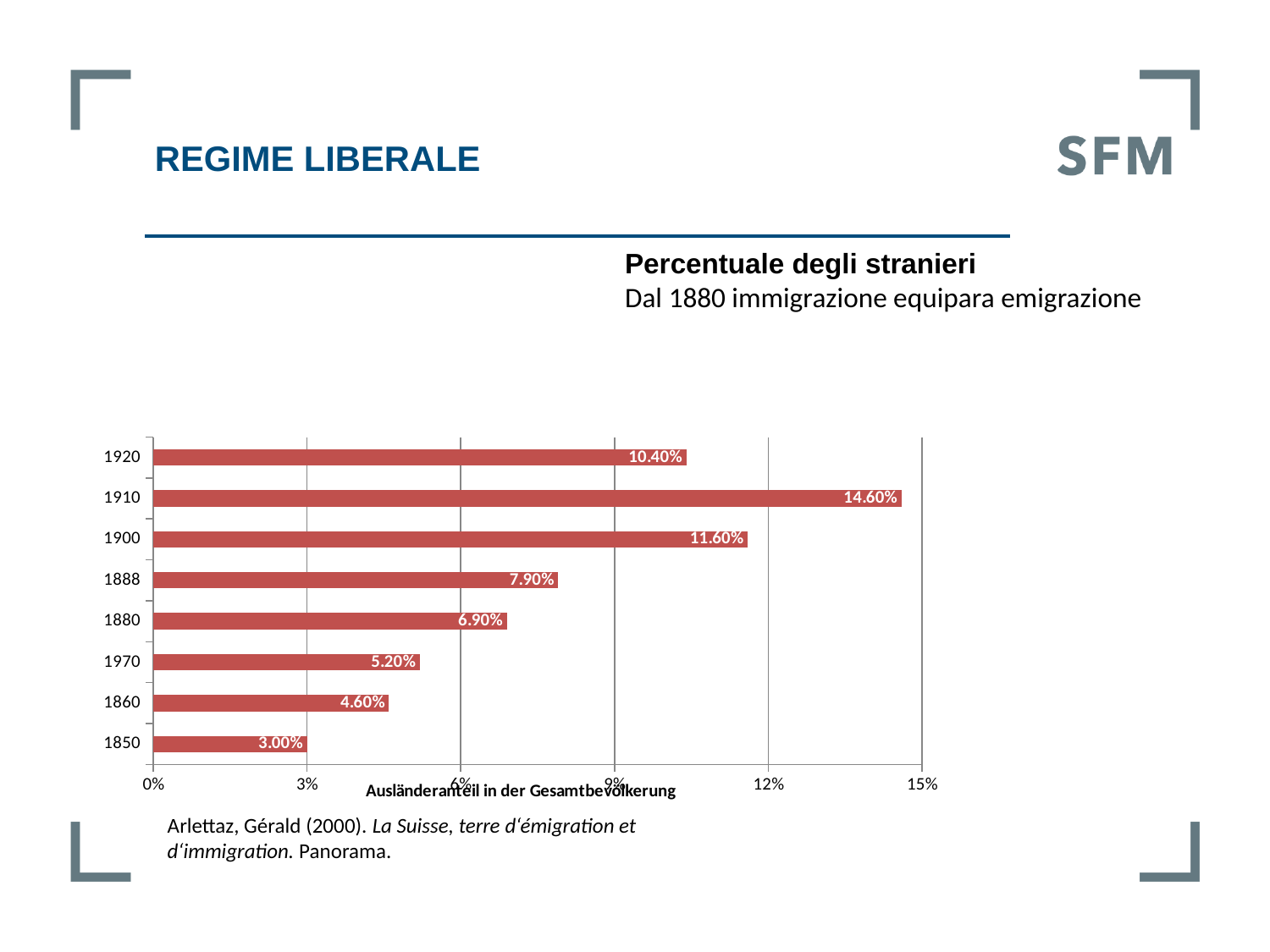
What is the value for 1850? 3.00% What is the title of the horizontal axis of the chart? Ausländeranteil in der Gesamtbevölkerung What is the difference between the values for 1910 and 1920? 4.20% Which year has the lowest value? 1850 What is the value for 1910? 14.60% Which year has the highest value? 1910 Which is larger, the value for 1900 or the value for 1920? 1900 What is the value for the bar labelled 1970? 5.20% What kind of chart is shown on the slide? Bar chart How many bars are shown in the chart? 8 What is the value for 1888? 7.90% What is the difference between the values for 1900 and 1888? 3.70%